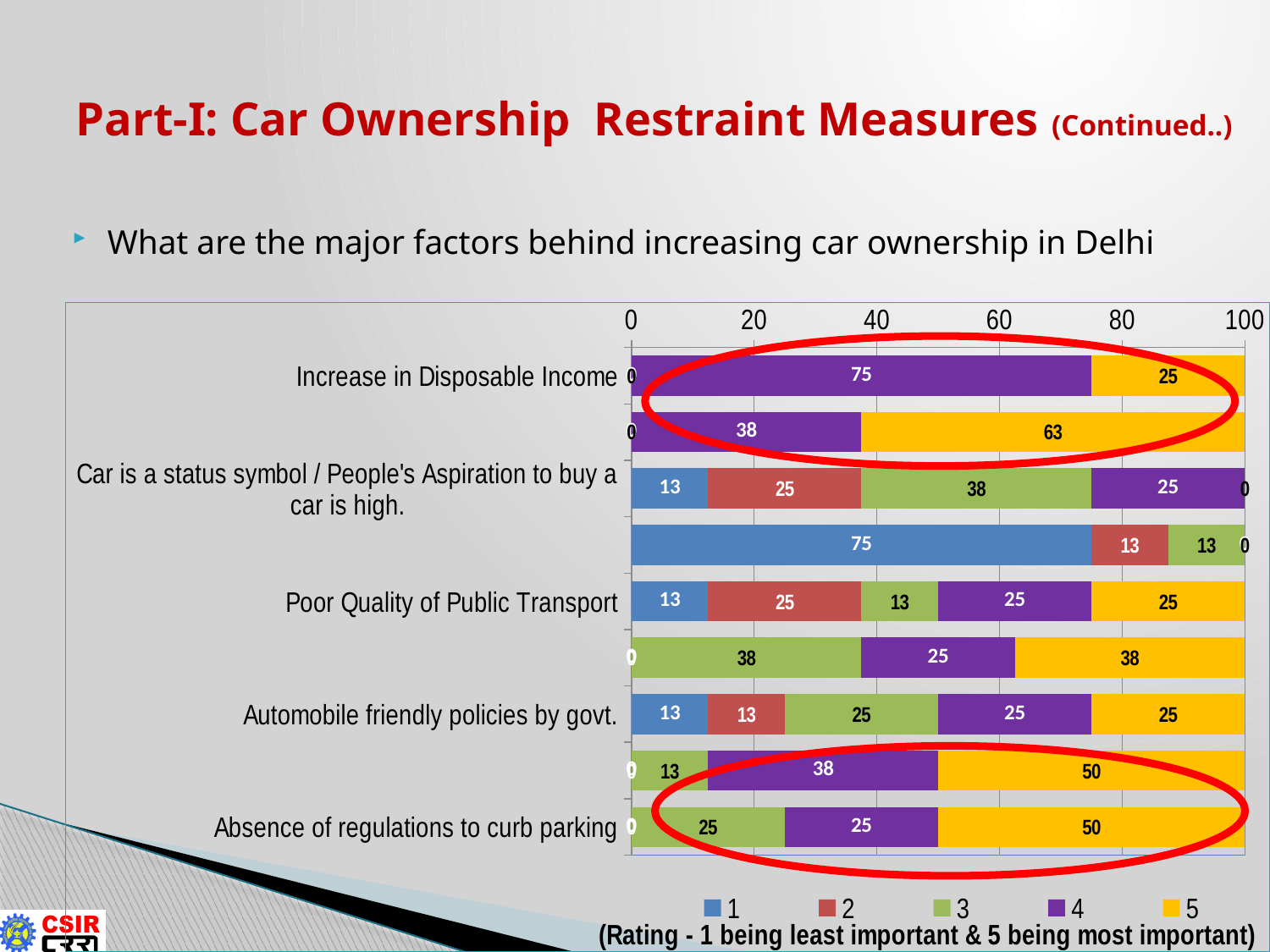
What is the value for rating 5 for 'Absence of regulations to curb parking'? 50 Which is larger for 'Car is a status symbol / People's Aspiration to buy a car is high.': the rating 3 value or the rating 1 value? rating 3 What is the value for rating 4 for 'Increase in Disposable Income'? 75 What is the value for rating 3 for 'Car is a status symbol / People's Aspiration to buy a car is high.'? 38 Which rating has the largest value for 'Increase in Disposable Income'? 4 What is the value for rating 2 for 'Poor Quality of Public Transport'? 25 What is the value for rating 5 for 'Increase in Disposable Income'? 25 What type of chart is shown on the slide? stacked bar chart Which rating has the largest value for 'Absence of regulations to curb parking'? 5 What is the value for rating 1 for 'Automobile friendly policies by govt.'? 13 How many series does the legend list? 5 What is the difference between the rating 4 and rating 5 values for 'Increase in Disposable Income'? 50